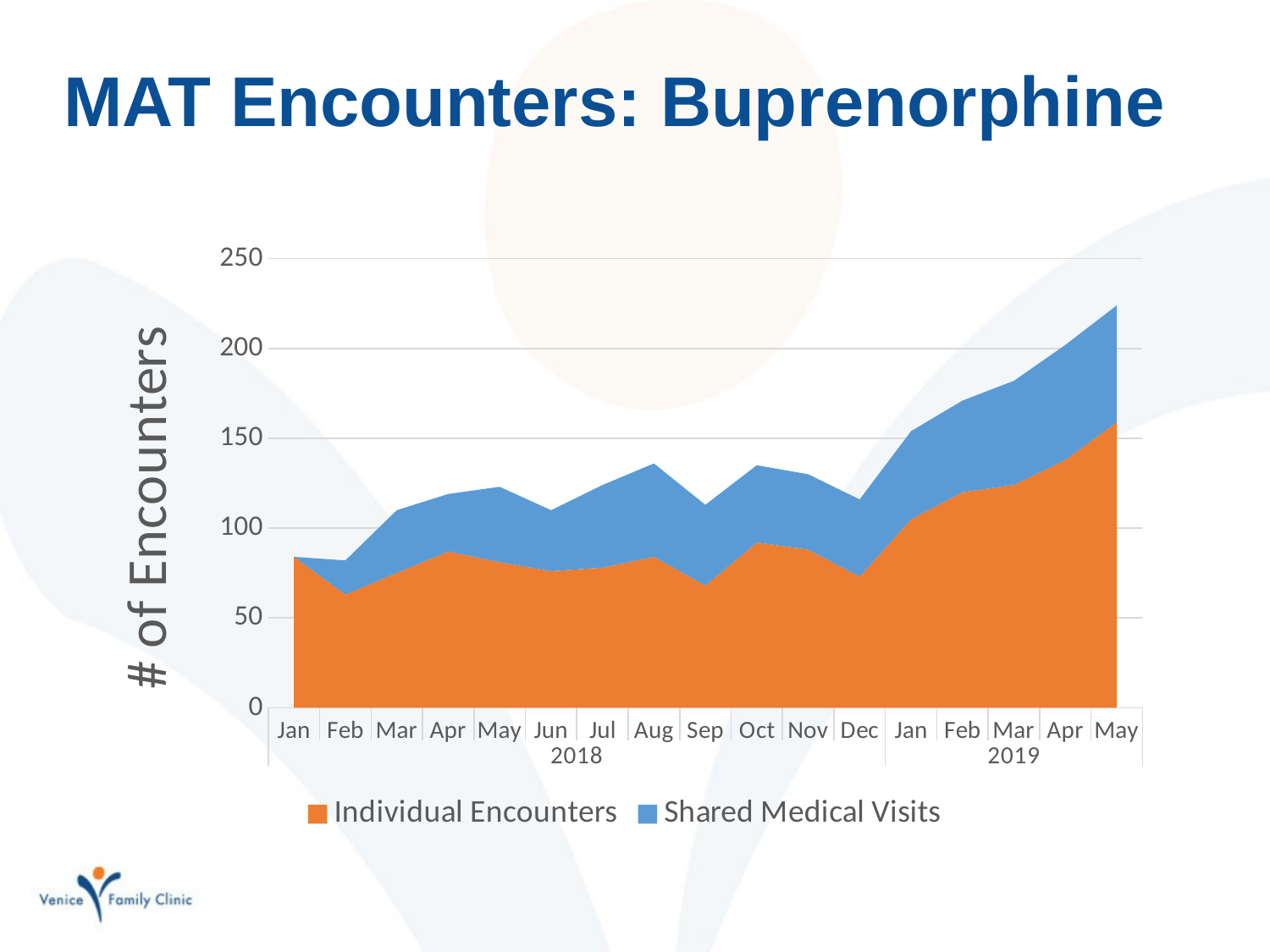
Is the value for Individual Encounters in Feb 2018 greater or less than 100? less Do Individual Encounters rise or fall from Dec 2018 to May 2019? Rise How many months are plotted along the x axis? 17 Is the total number of encounters in Jan 2018 greater or less than 100? less Is the total number of encounters in May 2019 greater or less than 200? greater What kind of chart is shown on the slide? Stacked area chart What is the title of the chart? MAT Encounters: Buprenorphine How many series does the legend list? 2 Which colour represents Shared Medical Visits? Blue In which month is the total number of encounters (both series combined) highest? May 2019